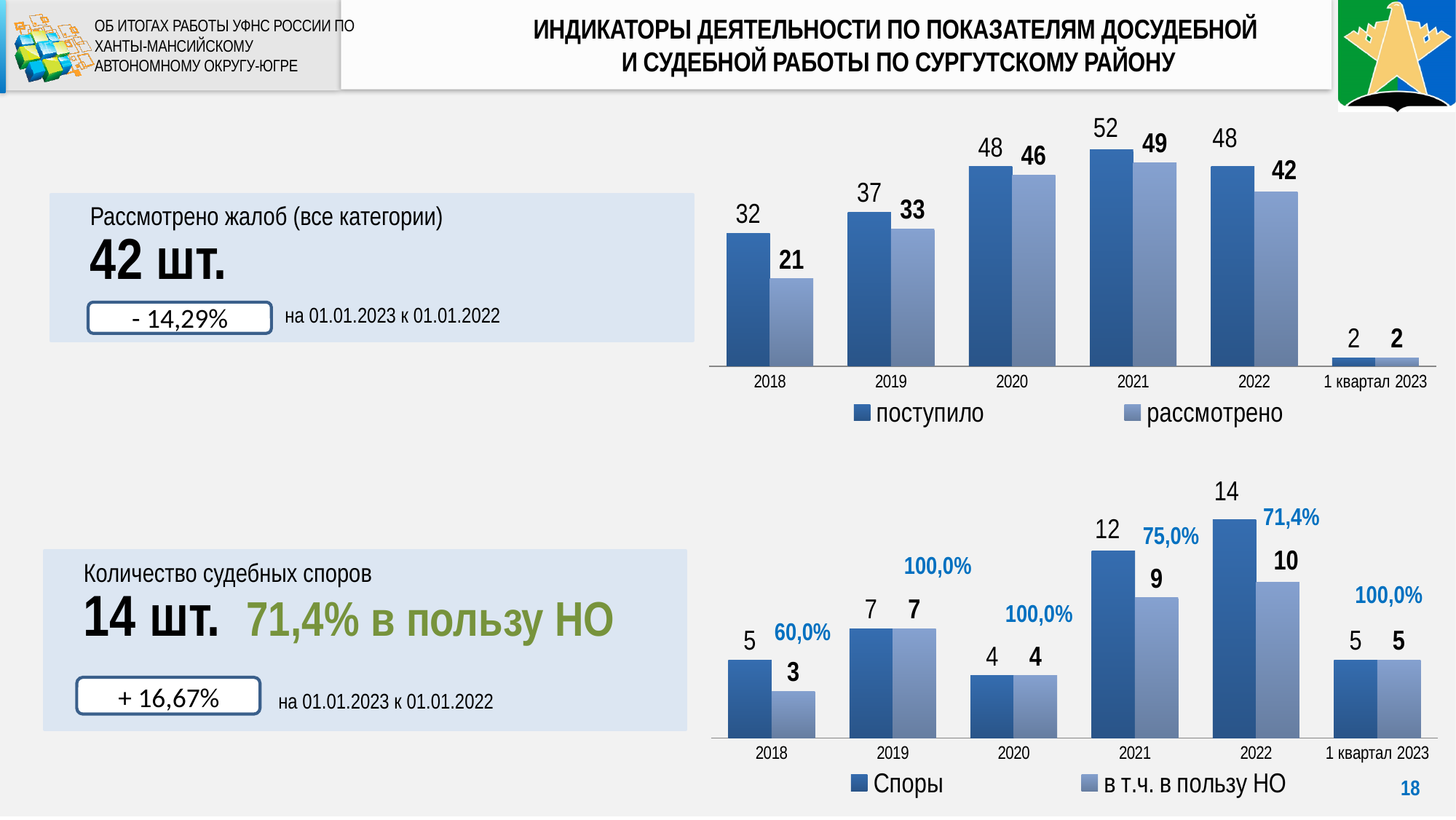
In the top chart, how many categories are shown on the x axis? 6 In the top chart, what is the value of "рассмотрено" for 2018? 21 In the top chart, what is the difference between "поступило" and "рассмотрено" for 2018? 11 In the bottom chart, is the value of "Споры" for 2021 larger or smaller than the value for 2022? smaller In the top chart, how many series does the legend list? 2 What type of chart is the bottom chart? bar chart In the bottom chart, what percentage is shown above the 2021 bars? 75,0% In the bottom chart, which year has the lowest value for "Споры"? 2020 In the top chart, which year has the highest value for "поступило"? 2021 In the bottom chart, what is the difference between "Споры" and "в т.ч. в пользу НО" for 2022? 4 In the top chart, what is the value of "поступило" for 2021? 52 In the bottom chart, what is the value of "Споры" for 2022? 14